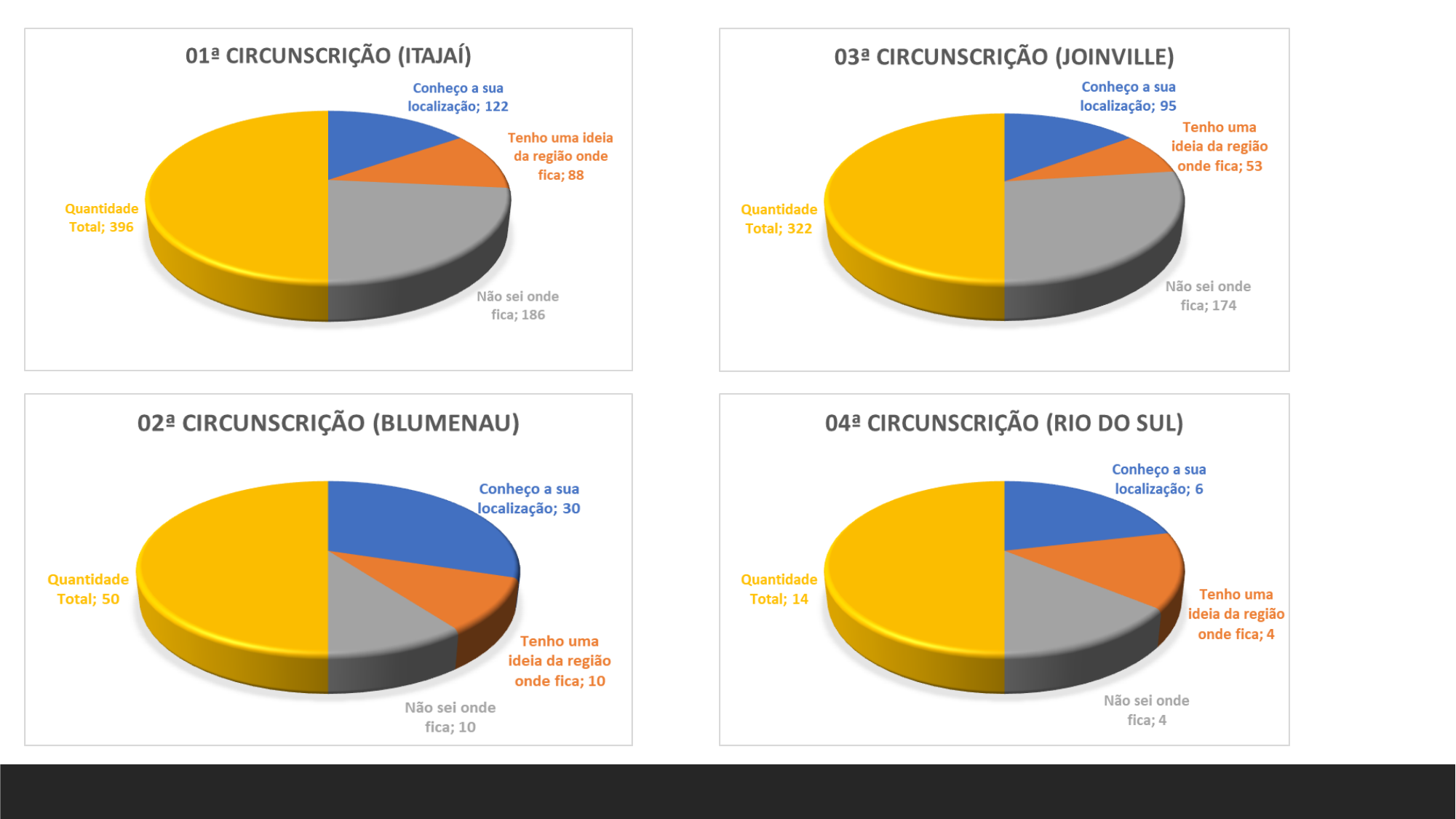
In the 01ª CIRCUNSCRIÇÃO (ITAJAÍ) chart, what is the value for "Não sei onde fica"? 186 In the 03ª CIRCUNSCRIÇÃO (JOINVILLE) chart, what is the value for "Conheço a sua localização"? 95 In the 03ª CIRCUNSCRIÇÃO (JOINVILLE) chart, which slice is the smallest? Tenho uma ideia da região onde fica In the 03ª CIRCUNSCRIÇÃO (JOINVILLE) chart, what is the difference between "Não sei onde fica" and "Conheço a sua localização"? 79 What kind of chart is the 04ª CIRCUNSCRIÇÃO (RIO DO SUL) chart? Pie chart In the 01ª CIRCUNSCRIÇÃO (ITAJAÍ) chart, which slice is the largest? Quantidade Total How many slices does the 02ª CIRCUNSCRIÇÃO (BLUMENAU) chart have? 4 In the 04ª CIRCUNSCRIÇÃO (RIO DO SUL) chart, what is the value for "Quantidade Total"? 14 In the 04ª CIRCUNSCRIÇÃO (RIO DO SUL) chart, which is larger: "Conheço a sua localização" or "Tenho uma ideia da região onde fica"? Conheço a sua localização In the 01ª CIRCUNSCRIÇÃO (ITAJAÍ) chart, what is the difference between "Não sei onde fica" and "Conheço a sua localização"? 64 In the 02ª CIRCUNSCRIÇÃO (BLUMENAU) chart, what is the value for "Tenho uma ideia da região onde fica"? 10 In the 02ª CIRCUNSCRIÇÃO (BLUMENAU) chart, what share of the pie does "Conheço a sua localização" represent? 30%